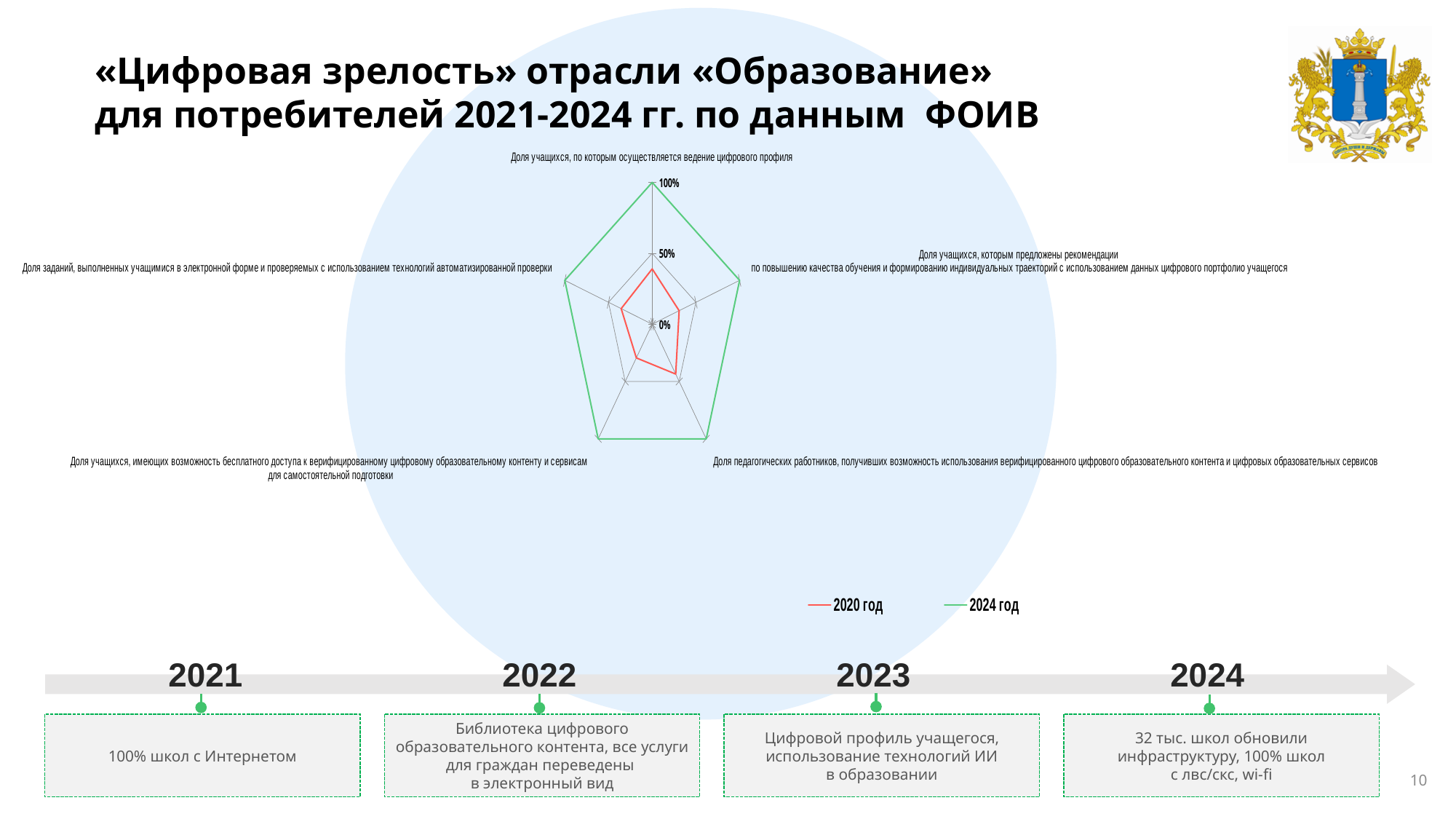
Is the value for 2020 год on the axis «Доля учащихся, по которым осуществляется ведение цифрового профиля» greater or less than 50%? less How many series does the chart legend list? 2 What is the highest tick value shown on the radar chart's axis scale? 100% Which series does the legend show in red? 2020 год What is the value for 2024 год on the axis «Доля учащихся, по которым осуществляется ведение цифрового профиля»? 100% Which series does the legend show in green? 2024 год Which series has the smaller value on the axis «Доля учащихся, имеющих возможность бесплатного доступа к верифицированному цифровому образовательному контенту и сервисам для самостоятельной подготовки»: 2020 год or 2024 год? 2020 год Which series has the larger value on the axis «Доля учащихся, которым предложены рекомендации по повышению качества обучения...»: 2020 год or 2024 год? 2024 год Is the value for 2024 год on the axis «Доля педагогических работников, получивших возможность использования верифицированного цифрового образовательного контента и цифровых образовательных сервисов» greater or less than 50%? greater What kind of chart is shown on the slide? radar chart Is the value for 2020 год on the axis «Доля заданий, выполненных учащимися в электронной форме и проверяемых с использованием технологий автоматизированной проверки» greater or less than 50%? less How many axes (categories) does the radar chart have? 5